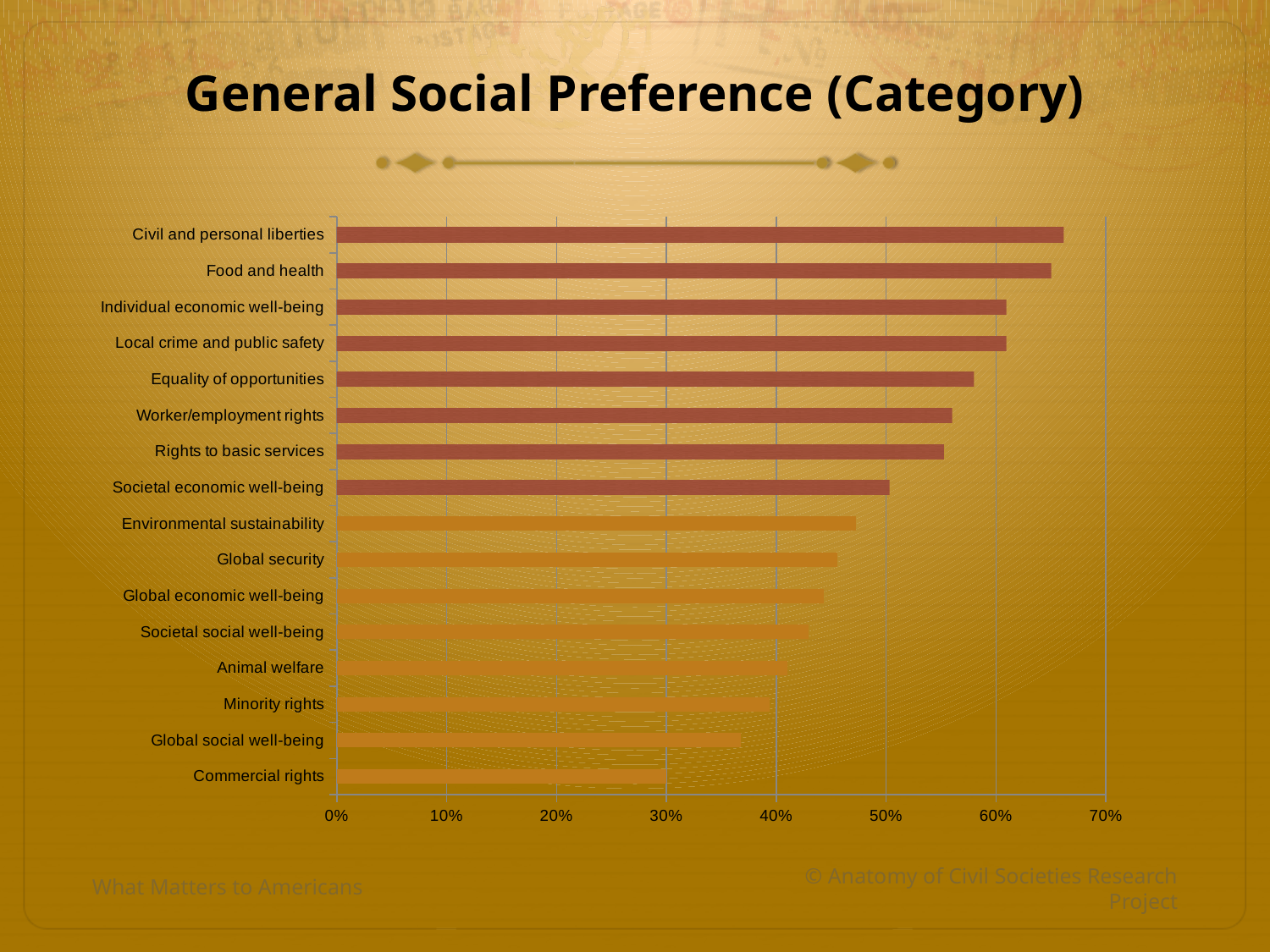
Is the value for Commercial rights greater or less than 40%? less Do the bar values increase or decrease going from the top category to the bottom category? Decrease Is the value for Equality of opportunities greater or less than 50%? greater What kind of chart is shown on the slide? Bar chart Which category has the highest value? Civil and personal liberties Is the value for Civil and personal liberties greater or less than 60%? greater Which has a larger value, Food and health or Global security? Food and health What is the title of the chart? General Social Preference (Category) Which category has the lowest value? Commercial rights How many categories are plotted in the chart? 16